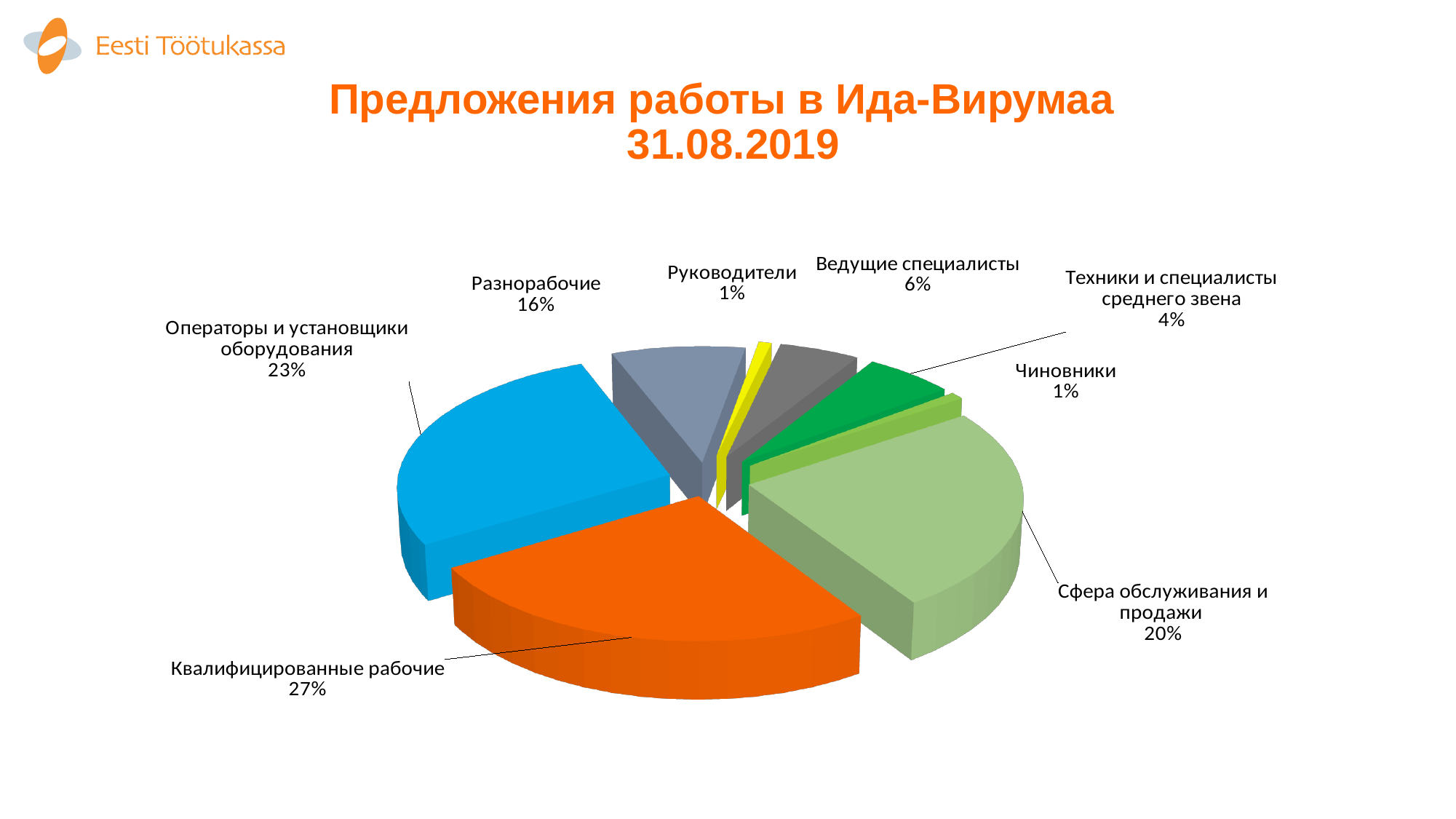
What share of job offers is for Операторы и установщики оборудования? 23% What kind of chart is shown on the slide? Pie chart What share of job offers is for Техники и специалисты среднего звена? 4% What share of job offers is for Сфера обслуживания и продажи? 20% How many categories (slices) does the pie chart have? 8 Which has a larger share: Разнорабочие or Сфера обслуживания и продажи? Сфера обслуживания и продажи What is the title of the chart on the slide? Предложения работы в Ида-Вирумаа 31.08.2019 Which category has the largest share of the pie? Квалифицированные рабочие What is the difference in share between Квалифицированные рабочие and Операторы и установщики оборудования? 4%